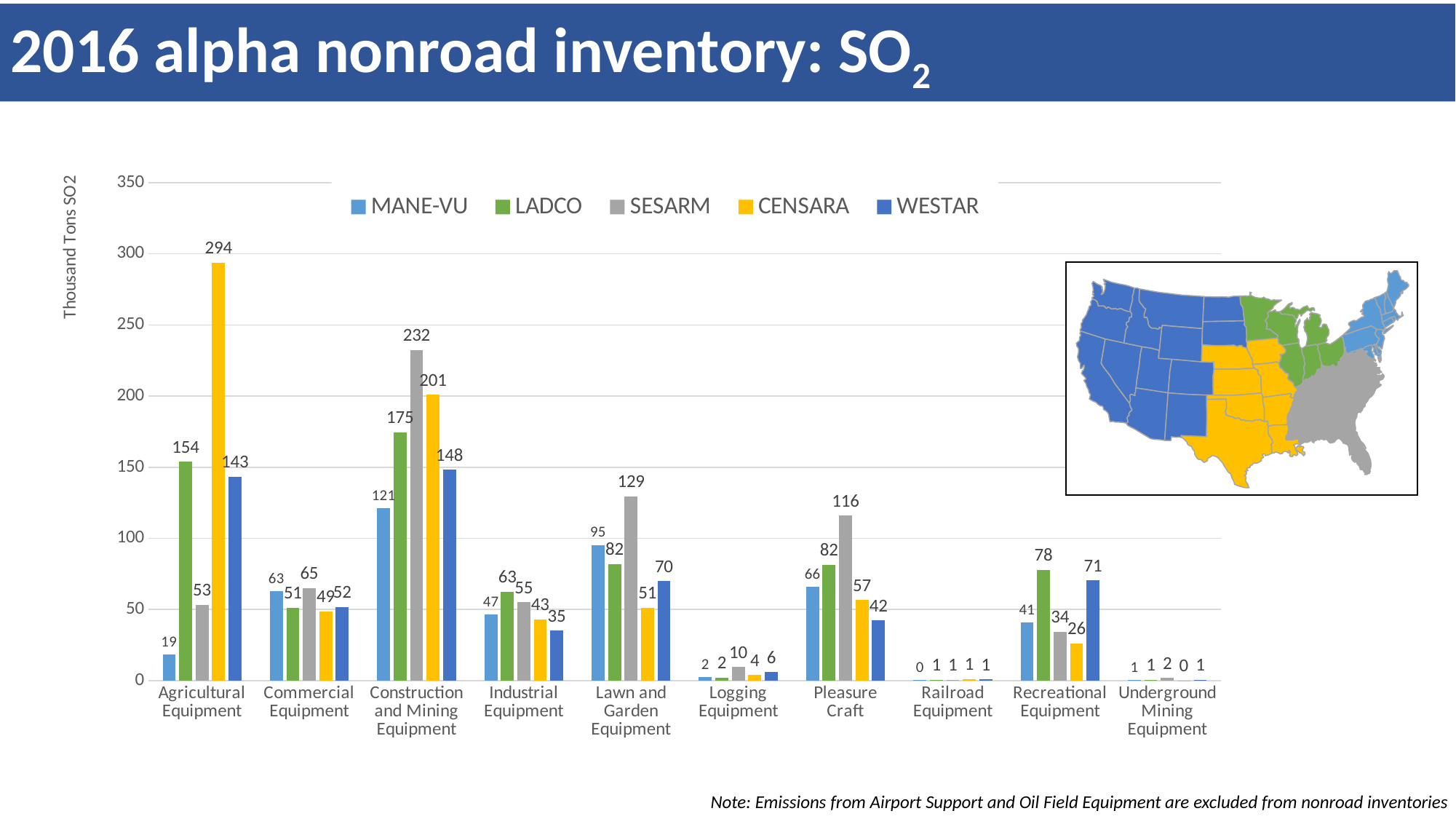
What is the y-axis label of the chart? Thousand Tons SO2 Is the CENSARA value for Construction and Mining Equipment greater or less than 200? greater How many equipment categories are shown on the x axis? 10 Which region has the highest value for Lawn and Garden Equipment? SESARM Which is larger for Industrial Equipment: the LADCO value or the WESTAR value? LADCO How many series does the legend list? 5 What is the CENSARA value for Agricultural Equipment? 294 What is the difference between the LADCO and MANE-VU values for Pleasure Craft? 16 What is the WESTAR value for Recreational Equipment? 71 Which region has the lowest value for Agricultural Equipment? MANE-VU What is the SESARM value for Construction and Mining Equipment? 232 What kind of chart is shown on the slide? Bar chart